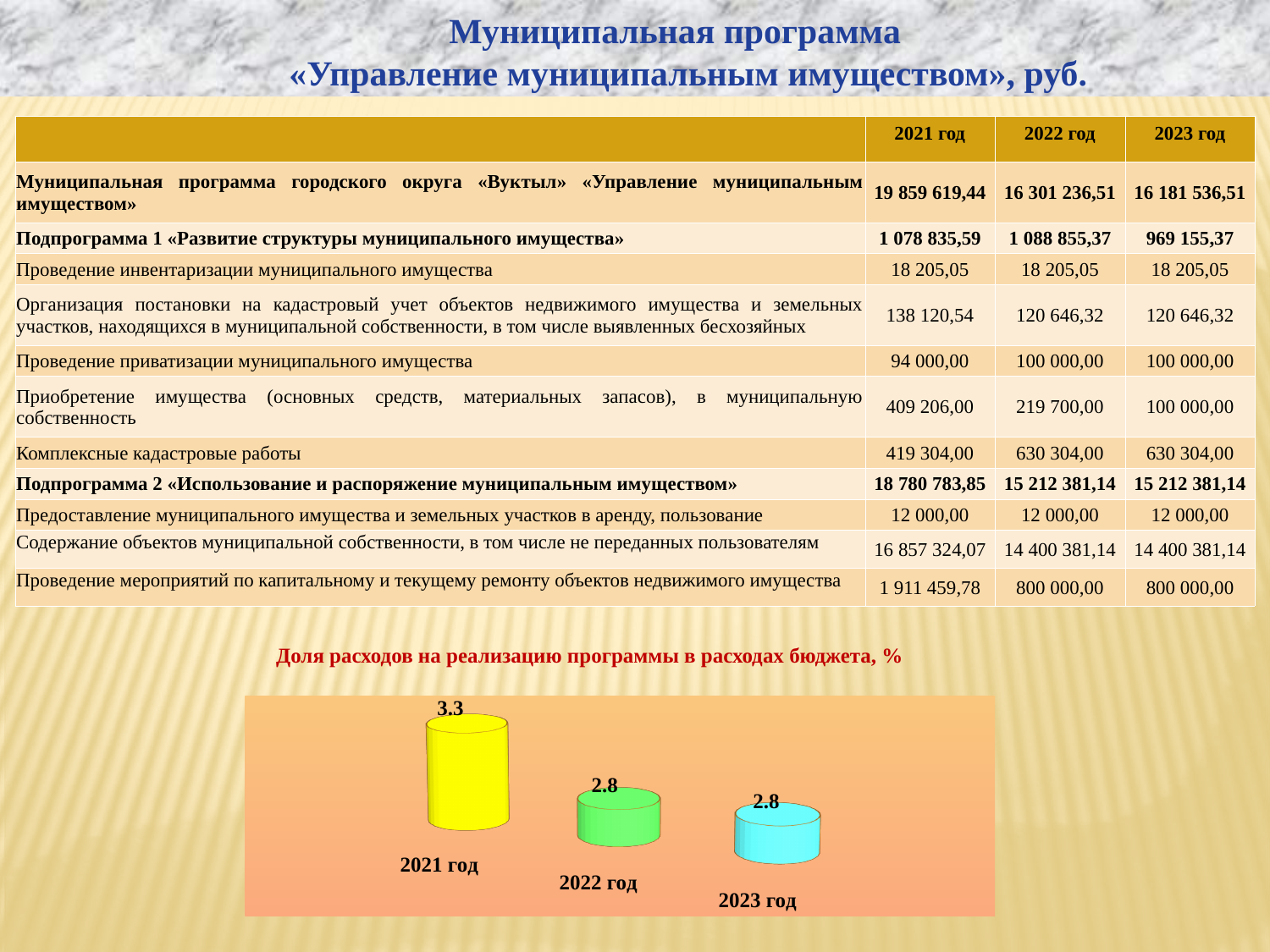
What is the difference between the values for 2021 год and 2022 год in the chart 'Доля расходов на реализацию программы в расходах бюджета, %'? 0.5 What is the title of the chart at the bottom of the slide? Доля расходов на реализацию программы в расходах бюджета, % Are the values for 2022 год and 2023 год in the chart 'Доля расходов на реализацию программы в расходах бюджета, %' the same or different? The same What is the value for 2022 год in the chart 'Доля расходов на реализацию программы в расходах бюджета, %'? 2.8 In the chart 'Доля расходов на реализацию программы в расходах бюджета, %', which is larger: the value for 2021 год or the value for 2023 год? 2021 год What colour is the bar for 2021 год in the chart 'Доля расходов на реализацию программы в расходах бюджета, %'? Yellow Which year has the highest value in the chart 'Доля расходов на реализацию программы в расходах бюджета, %'? 2021 год How many years are shown in the chart 'Доля расходов на реализацию программы в расходах бюджета, %'? 3 What is the value for 2021 год in the chart 'Доля расходов на реализацию программы в расходах бюджета, %'? 3.3 What is the value for 2023 год in the chart 'Доля расходов на реализацию программы в расходах бюджета, %'? 2.8 What kind of chart is 'Доля расходов на реализацию программы в расходах бюджета, %'? Bar chart Do the values in the chart 'Доля расходов на реализацию программы в расходах бюджета, %' rise or fall from 2021 год to 2022 год? Fall